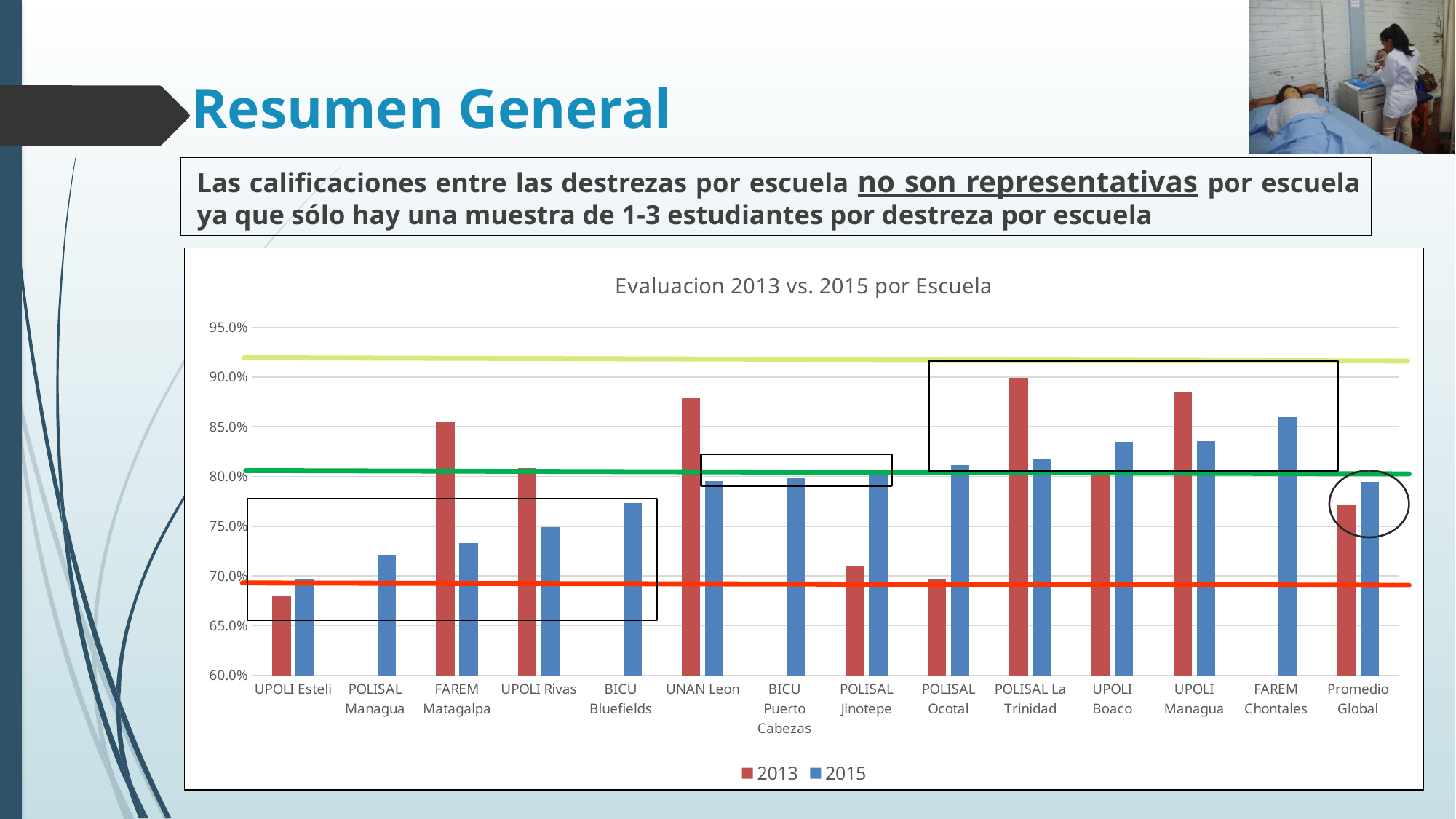
Which category has the lowest 2015 value? UPOLI Esteli What is the title of the chart? Evaluacion 2013 vs. 2015 por Escuela Which category has the highest 2015 value? FAREM Chontales For POLISAL Ocotal, which is larger: the 2013 value or the 2015 value? 2015 How many categories are shown on the x axis of the chart? 14 Is the 2013 value for POLISAL Jinotepe greater or less than 75.0%? less For FAREM Matagalpa, which is larger: the 2013 value or the 2015 value? 2013 Which school has the highest 2013 value? POLISAL La Trinidad Which school has the lowest 2013 value? UPOLI Esteli What kind of chart is shown on the slide? Bar chart Is the 2013 value for UNAN Leon greater or less than 85.0%? greater How many series does the legend list? 2